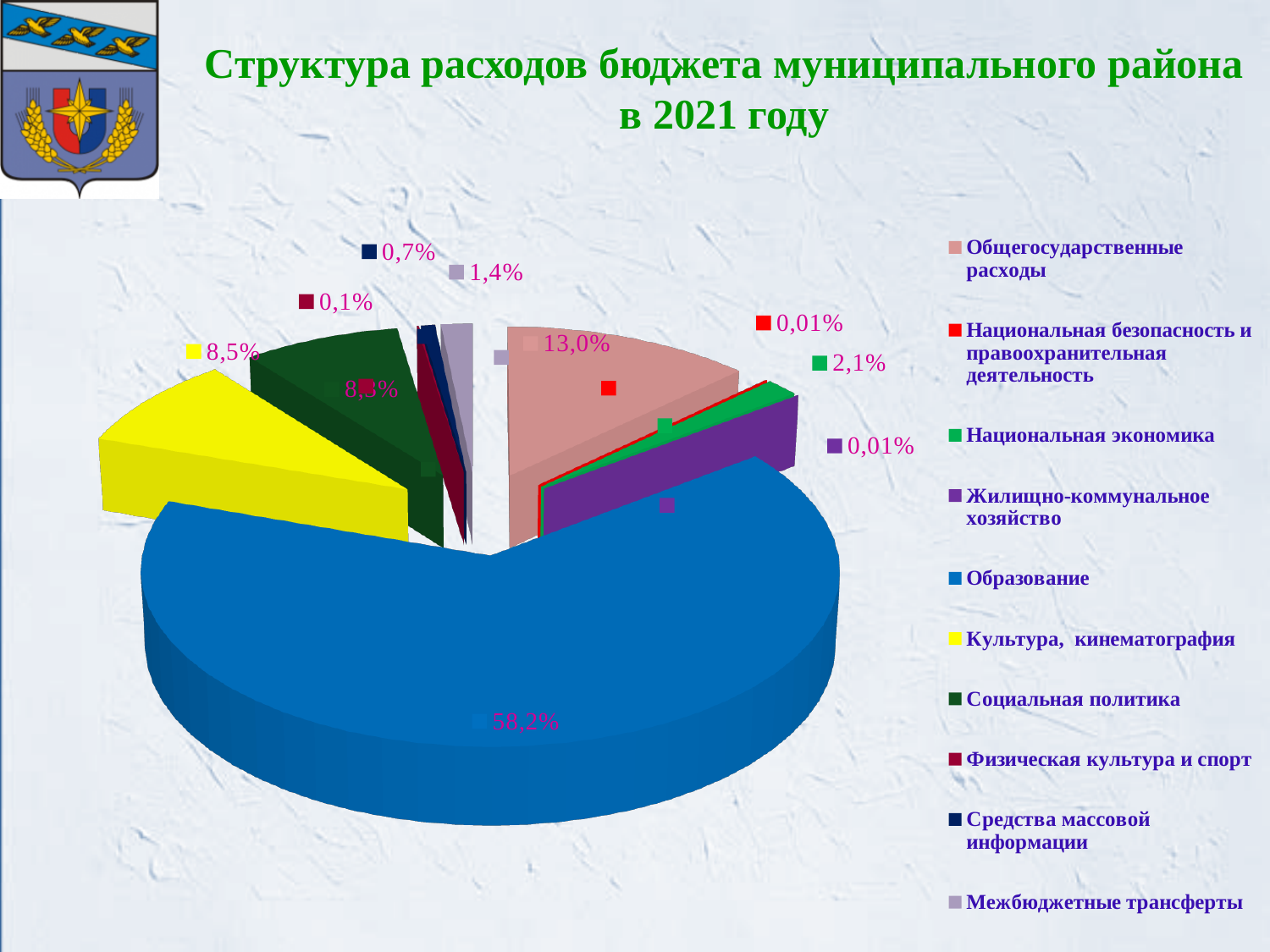
What share of the budget expenditure goes to Образование? 58,2% Which category has the largest share of the pie? Образование What is the value shown for Средства массовой информации? 0,7% What is the difference between the shares of Общегосударственные расходы and Культура, кинематография? 4,5% What kind of chart is shown on the slide? pie chart What is the value shown for Общегосударственные расходы? 13,0% How many categories does the legend list? 10 What is the value shown for Межбюджетные трансферты? 1,4% Which is larger: Общегосударственные расходы or Культура, кинематография? Общегосударственные расходы What is the value shown for Физическая культура и спорт? 0,1% What is the value shown for Национальная экономика? 2,1% What is the value shown for Культура, кинематография? 8,5%